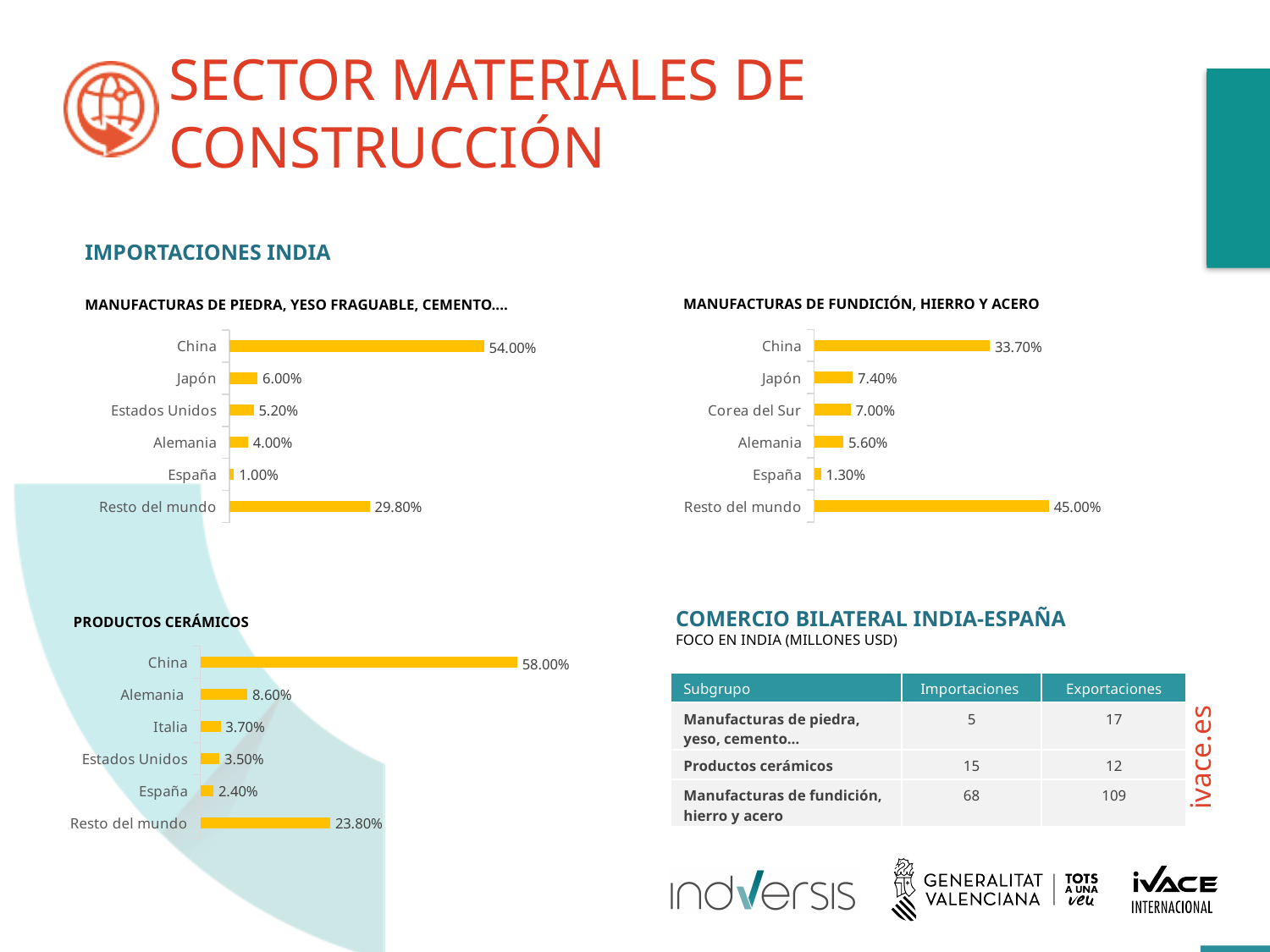
In the 'PRODUCTOS CERÁMICOS' chart, how many categories are shown? 6 How many bar charts are shown on the slide? 3 In the 'MANUFACTURAS DE FUNDICIÓN, HIERRO Y ACERO' chart, what is the difference between the values for Resto del mundo and China? 11.30% In the 'MANUFACTURAS DE PIEDRA, YESO FRAGUABLE, CEMENTO....' chart, which category has the lowest value? España In the 'MANUFACTURAS DE PIEDRA, YESO FRAGUABLE, CEMENTO....' chart, what is the difference between the values for Japón and Estados Unidos? 0.80% In the 'MANUFACTURAS DE FUNDICIÓN, HIERRO Y ACERO' chart, which category has the highest value? Resto del mundo In the 'PRODUCTOS CERÁMICOS' chart, what is the value for España? 2.40% In the 'MANUFACTURAS DE FUNDICIÓN, HIERRO Y ACERO' chart, which is larger, the value for China or the value for Resto del mundo? Resto del mundo What type of chart is the 'PRODUCTOS CERÁMICOS' chart? Bar chart In the 'MANUFACTURAS DE FUNDICIÓN, HIERRO Y ACERO' chart, what is the value for Corea del Sur? 7.00% In the 'PRODUCTOS CERÁMICOS' chart, what is the value for Alemania? 8.60% In the 'MANUFACTURAS DE PIEDRA, YESO FRAGUABLE, CEMENTO....' chart, what is the value for China? 54.00%